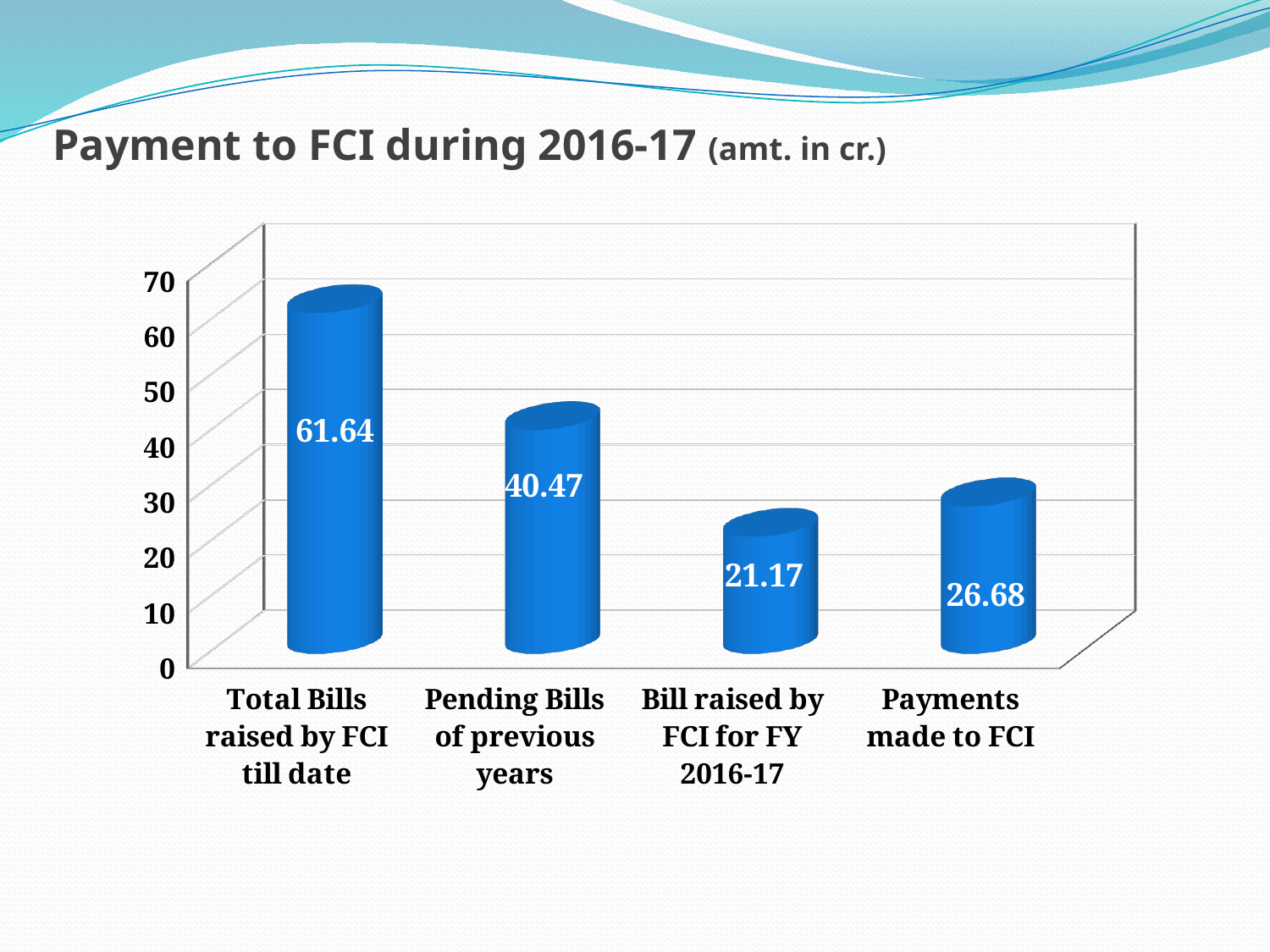
What is the value for Pending Bills of previous years? 40.47 What unit are the amounts in the chart expressed in, according to the title? cr. Which is larger: Payments made to FCI or Bill raised by FCI for FY 2016-17? Payments made to FCI How many categories are shown in the chart? 4 What is the value for Payments made to FCI? 26.68 Which category has the highest value? Total Bills raised by FCI till date What is the value for Total Bills raised by FCI till date? 61.64 Which category has the lowest value? Bill raised by FCI for FY 2016-17 What is the difference between Total Bills raised by FCI till date and Payments made to FCI? 34.96 What is the difference between Pending Bills of previous years and Bill raised by FCI for FY 2016-17? 19.30 What is the value for Bill raised by FCI for FY 2016-17? 21.17 What kind of chart is shown on the slide? Bar chart